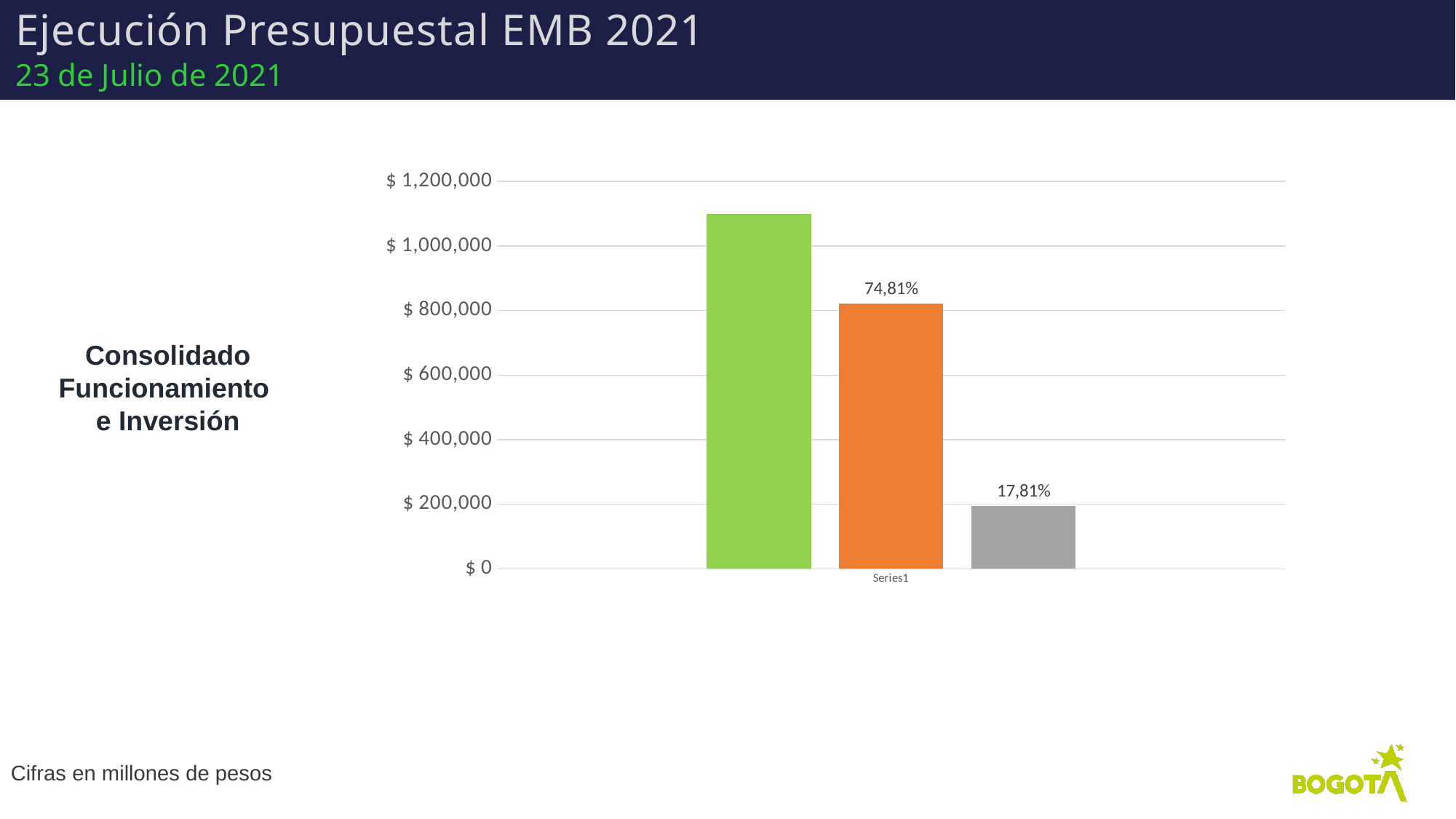
Is the value of the orange bar greater or less than $ 800,000? greater What percentage label is printed above the grey bar? 17,81% What percentage label is printed above the orange bar? 74,81% What is the highest tick value shown on the vertical axis? $ 1,200,000 What is the title of the slide containing the chart? Ejecución Presupuestal EMB 2021 What kind of chart is shown on the slide? bar chart How many bars are plotted in the chart? 3 Which bar is the shortest in the chart: the green, orange or grey bar? grey Which bar is taller, the orange bar or the grey bar? orange Is the value of the green bar greater or less than $ 1,000,000? greater Which bar is the tallest in the chart: the green, orange or grey bar? green